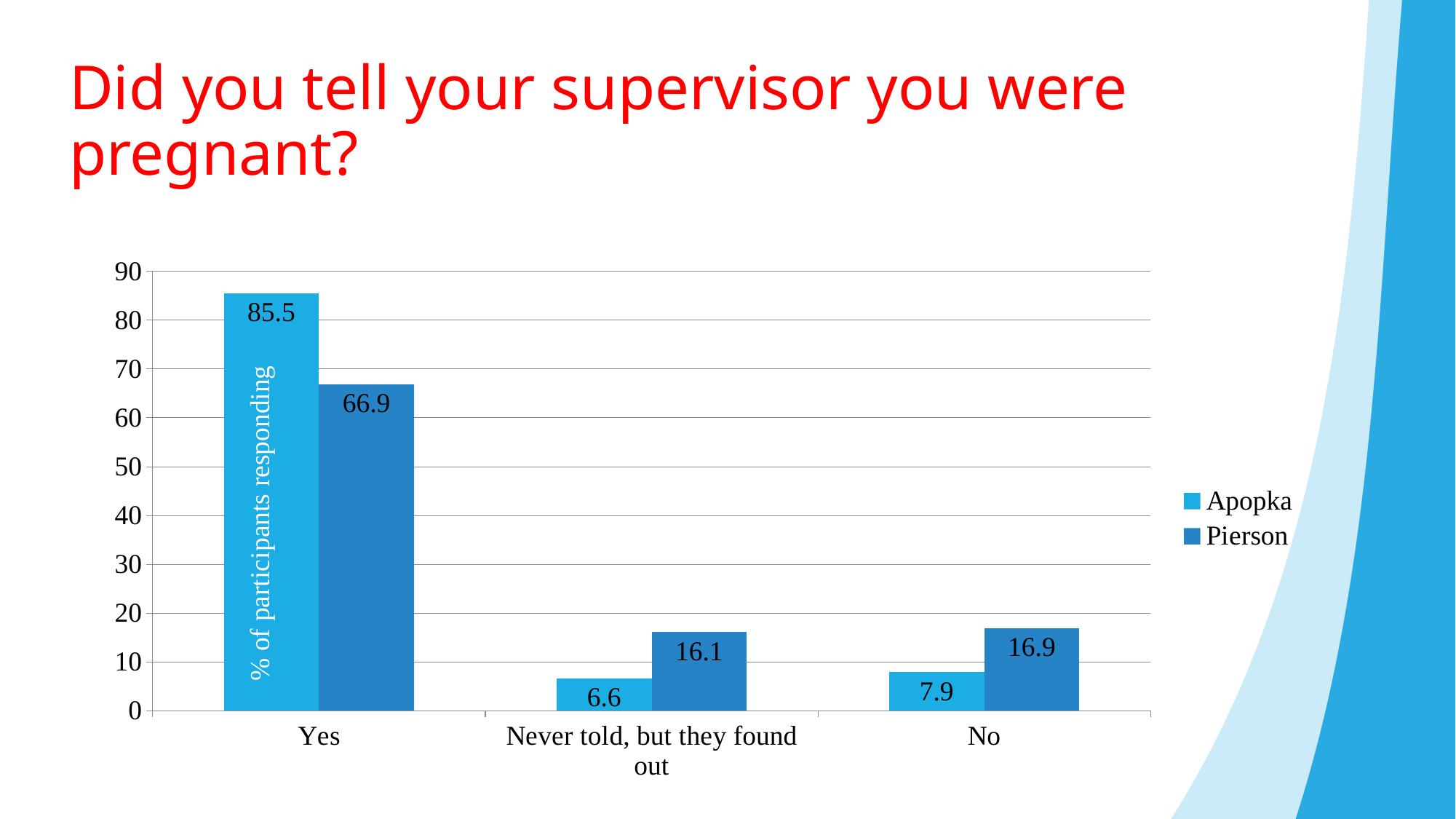
Which category has the highest value for Pierson? Yes Which category has the lowest value for Apopka? Never told, but they found out What percentage of Apopka participants answered "Yes"? 85.5 What is the value for Apopka in the "Never told, but they found out" category? 6.6 What is the label on the vertical axis? % of participants responding Which is larger in the "No" category, Apopka or Pierson? Pierson How many series does the legend list? 2 What is the value for Pierson in the "No" category? 16.9 What kind of chart is shown on the slide? bar chart How many response categories are shown on the x axis? 3 What is the difference between the Apopka and Pierson values for "Yes"? 18.6 Is the Pierson value for "Yes" greater or less than 70? less